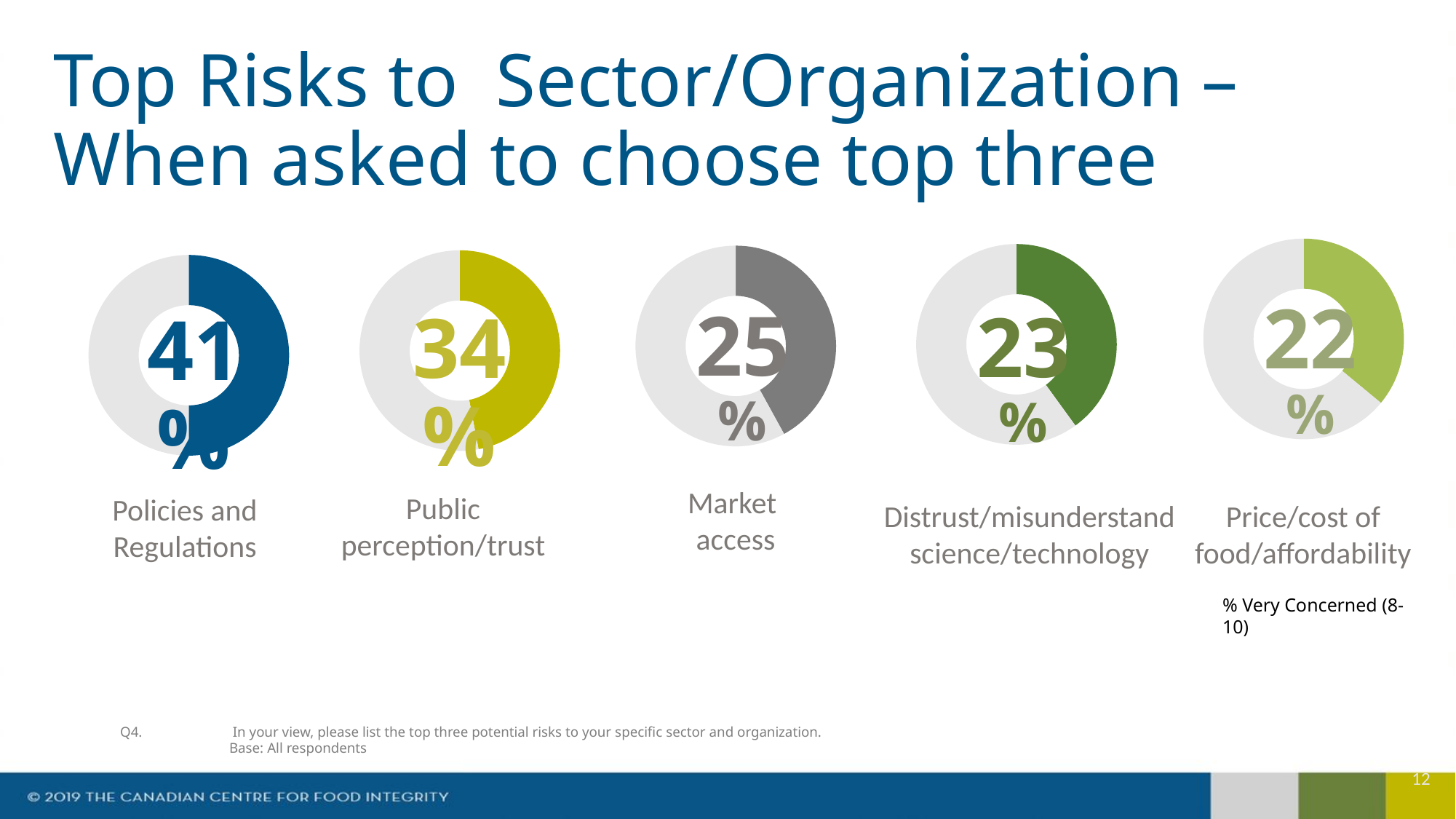
What percentage is shown in the donut chart for Price/cost of food/affordability? 22% What percentage is shown in the donut chart for Market access? 25% Which is larger: the percentage for Market access or the percentage for Distrust/misunderstand science/technology? Market access How many donut charts are shown on the slide? 5 Across the five donut charts, which risk has the lowest percentage? Price/cost of food/affordability What is the difference in percentage points between the Policies and Regulations chart and the Public perception/trust chart? 7 What percentage is shown in the donut chart for Policies and Regulations? 41% What kind of chart is used to display each risk percentage on the slide? Donut chart Across the five donut charts, which risk has the highest percentage? Policies and Regulations What percentage is shown in the donut chart for Distrust/misunderstand science/technology? 23% What colour is the filled portion of the Policies and Regulations donut chart? Blue What percentage is shown in the donut chart for Public perception/trust? 34%